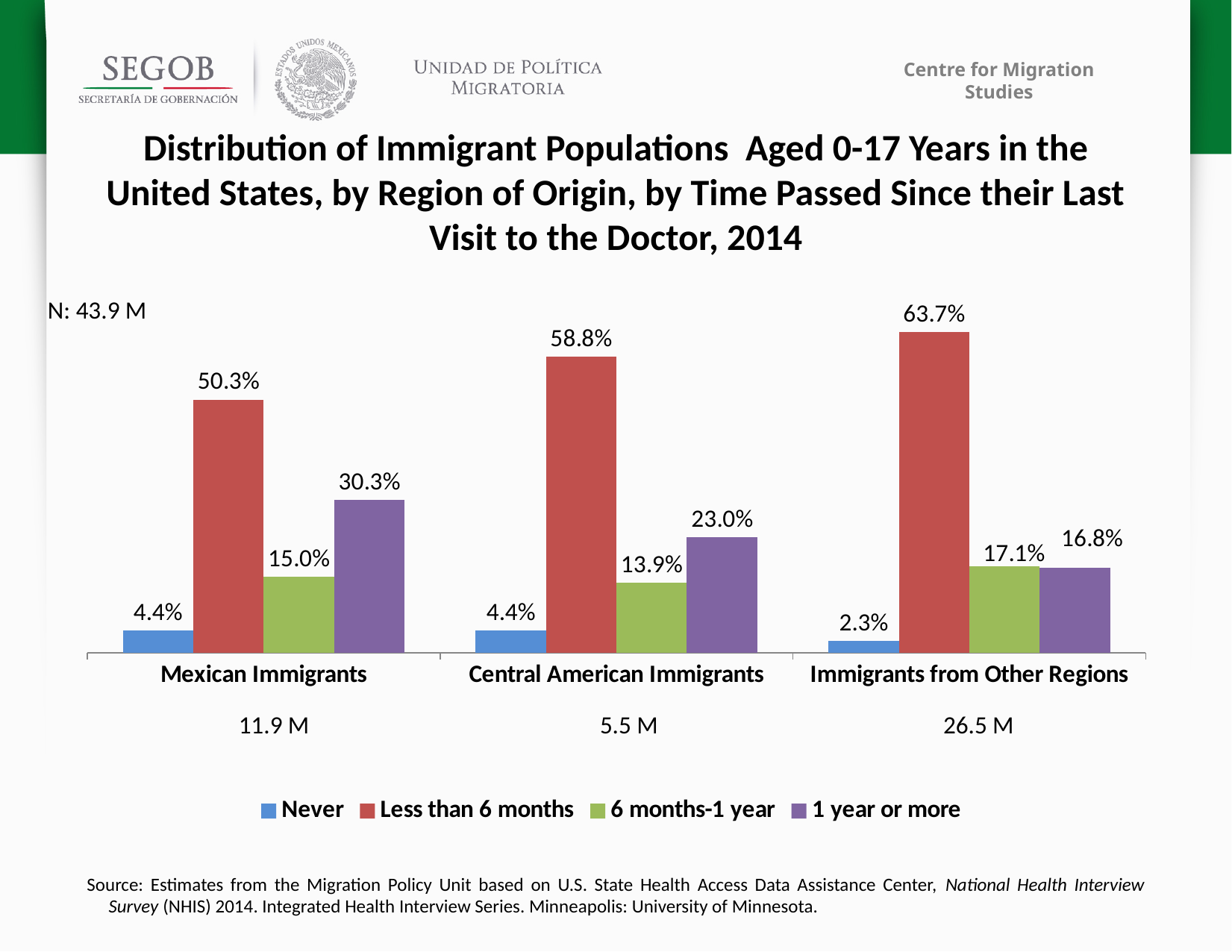
What kind of chart is shown on the slide? Bar chart What population size is shown below the Central American Immigrants category? 5.5 M How many region-of-origin categories are shown on the x axis? 3 What is the '6 months-1 year' value for Immigrants from Other Regions? 17.1% How many series does the legend list? 4 Which region of origin has the highest share in the 'Less than 6 months' category? Immigrants from Other Regions What percentage of Mexican immigrants aged 0-17 last visited the doctor less than 6 months ago? 50.3% What is the value for 'Never' among Immigrants from Other Regions? 2.3% What percentage of Central American immigrants fall in the '1 year or more' category? 23.0% Which region of origin has the lowest share in the '1 year or more' category? Immigrants from Other Regions Which is larger: the '1 year or more' value for Mexican Immigrants or for Central American Immigrants? Mexican Immigrants What is the difference between the 'Less than 6 months' values for Immigrants from Other Regions and Mexican Immigrants? 13.4%